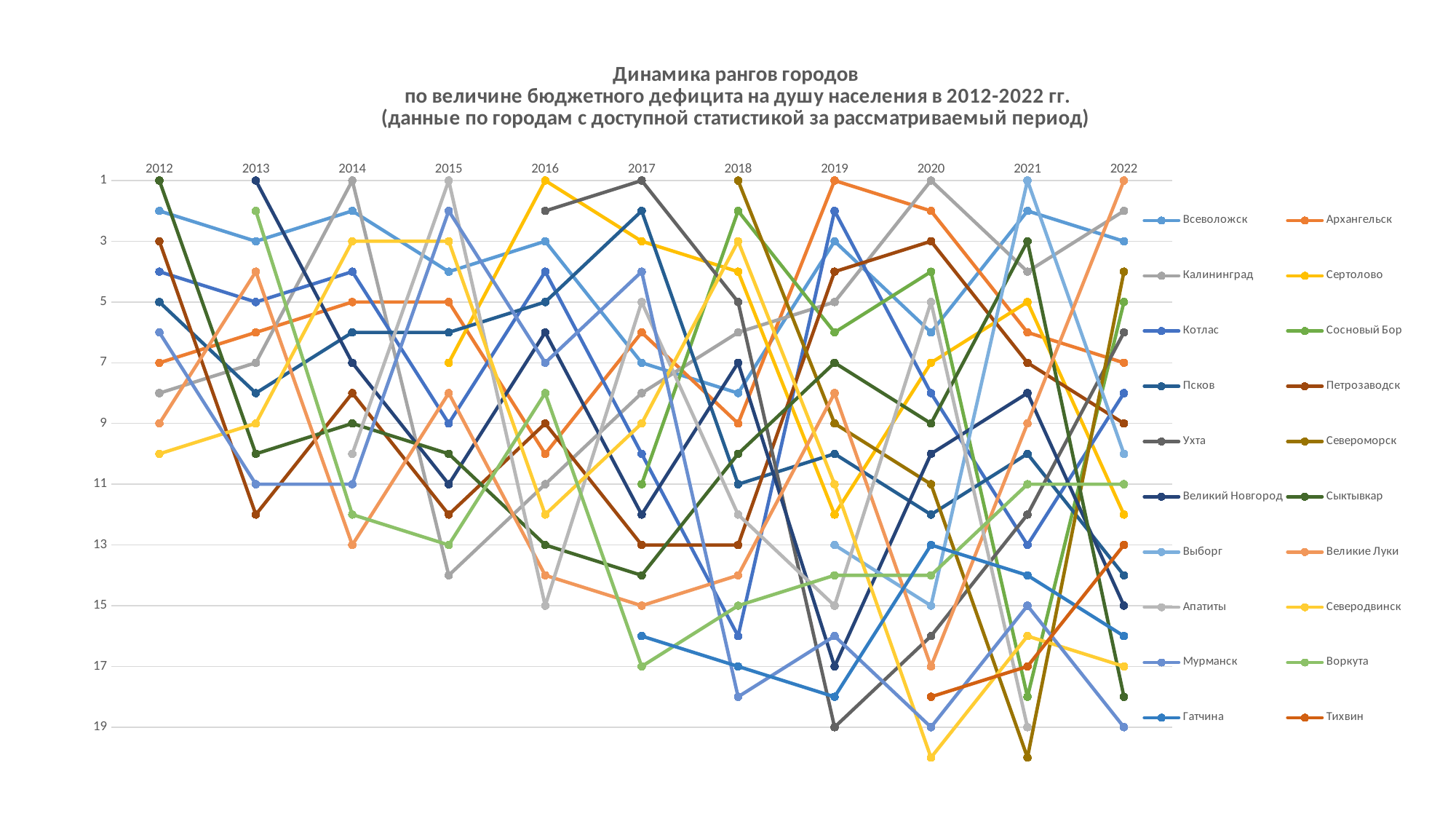
What rank does Архангельск hold in 2022? 7 Is the rank of Ухта in 2019 greater or less than 15? greater How many years are plotted along the x axis? 11 What kind of chart is shown on the slide? line chart What is the last year shown on the x axis? 2022 What rank does Архангельск hold in 2019? 1 Is the rank of Архангельск in 2020 greater or less than 5? less What is the first year shown on the x axis? 2012 How many cities (series) does the legend list? 20 Which is the largest rank value labelled on the y axis? 19 What rank does Ухта hold in 2017? 1